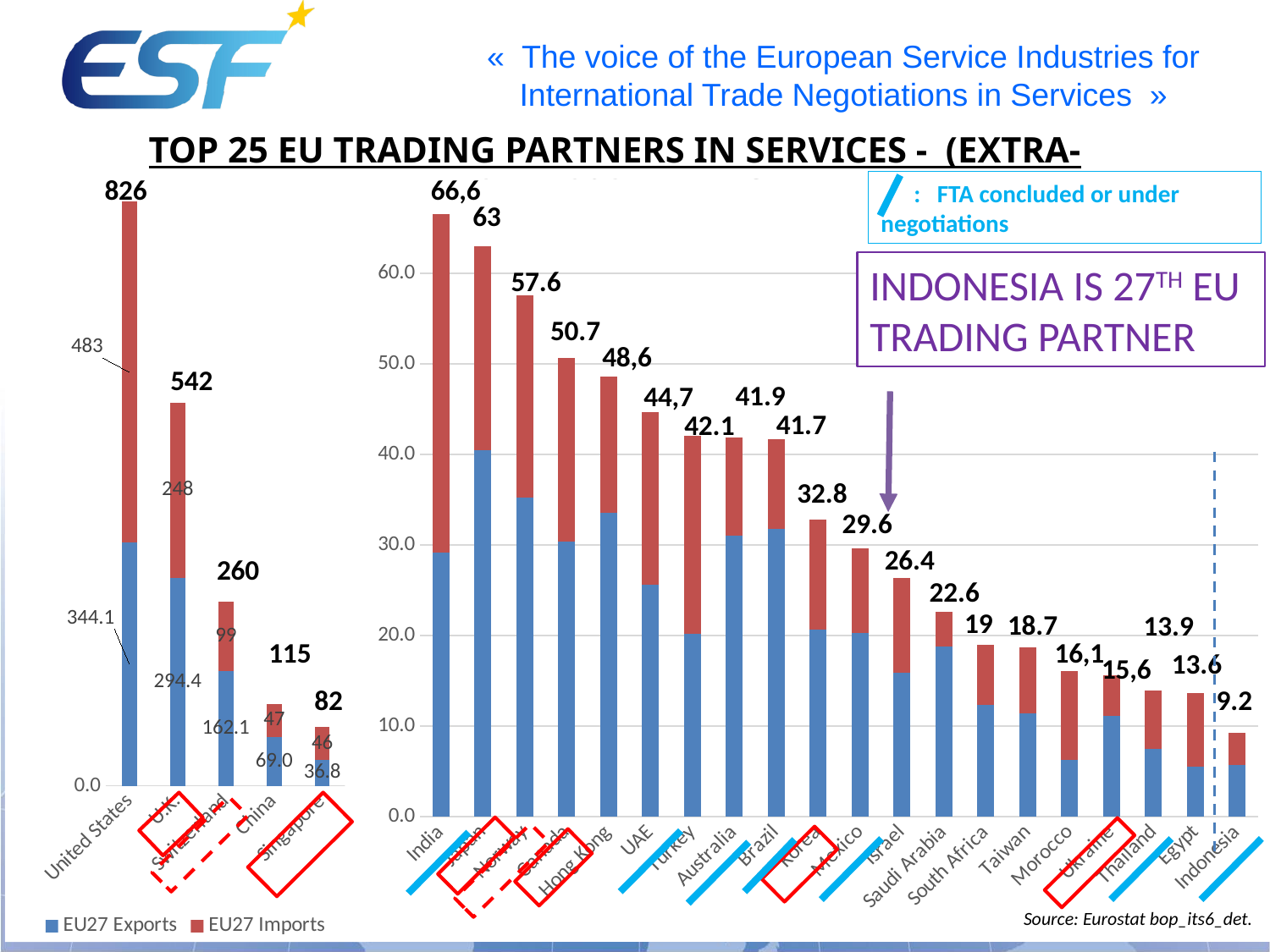
On the left chart, which country has the lowest total bar? Singapore On the left chart, how many countries are shown on the x axis? 5 On the left chart, what is the EU27 Exports value for the UK? 294.4 On the right chart, what is the value labelled above the bar for Indonesia? 9.2 How many series does the legend list? 2 On the right chart, which country has the highest total bar? India On the left chart, what is the total value labelled above the bar for United States? 826 On the right chart, how many countries are shown on the x axis? 20 On the left chart, what is the EU27 Imports value for Switzerland? 99 On the right chart, which has the larger labelled total, Canada or Hong Kong? Canada On the right chart, what is the difference between the labelled totals for Korea and Mexico? 3.2 On the right chart, what is the value labelled above the bar for Norway? 57.6